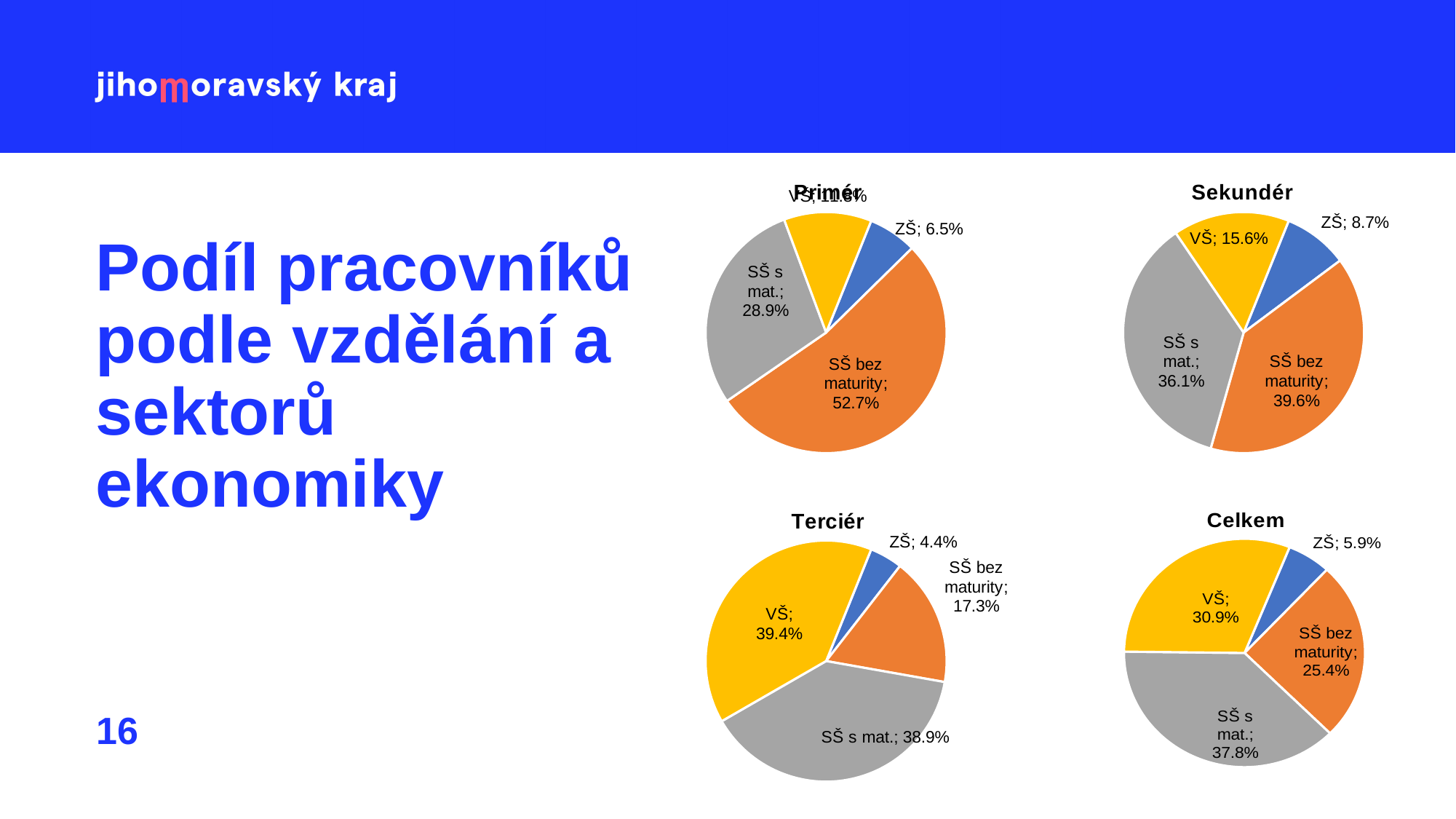
What colour is the SŠ bez maturity slice in the Primér chart? Orange In the Celkem chart, what share is labelled for ZŠ? 5.9% In the Celkem chart, which category has the largest slice? SŠ s mat. In the Sekundér chart, what share is labelled for SŠ s mat.? 36.1% In the Terciér chart, which category has the smallest slice? ZŠ In the Primér chart, what share is labelled for SŠ bez maturity? 52.7% How many slices does the Terciér pie chart have? 4 In the Celkem chart, what is the difference between the shares of SŠ s mat. and SŠ bez maturity? 12.4% What kind of chart is the Celkem chart? Pie chart In the Terciér chart, what share is labelled for VŠ? 39.4% In the Sekundér chart, which is larger: the share of VŠ or the share of ZŠ? VŠ In the Sekundér chart, which category has the largest slice? SŠ bez maturity